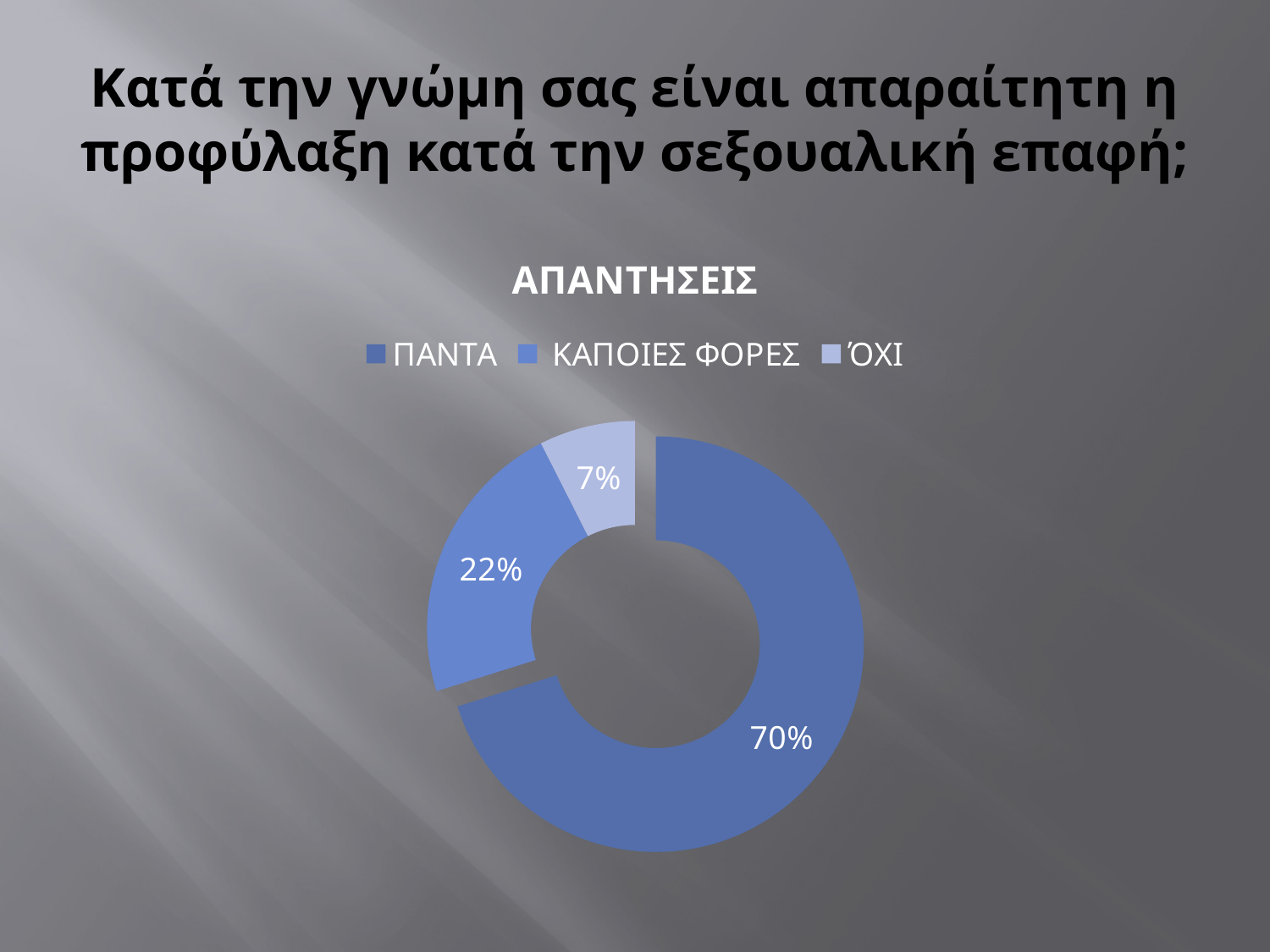
What is the difference in percentage points between ΚΑΠΟΙΕΣ ΦΟΡΕΣ and ΌΧΙ? 15 Which response category has the largest share? ΠΑΝΤΑ How many categories are shown in the chart? 3 Which response category has the smallest share? ΌΧΙ What percentage of responses is ΠΑΝΤΑ? 70% What percentage of responses is ΌΧΙ? 7% What is the title of the chart? ΑΠΑΝΤΗΣΕΙΣ Which category is shown in the lightest colour in the legend? ΌΧΙ What kind of chart is shown on the slide? Doughnut (pie) chart What is the difference in percentage points between ΠΑΝΤΑ and ΚΑΠΟΙΕΣ ΦΟΡΕΣ? 48 What percentage of responses is ΚΑΠΟΙΕΣ ΦΟΡΕΣ? 22% Which is larger, the share for ΚΑΠΟΙΕΣ ΦΟΡΕΣ or the share for ΌΧΙ? ΚΑΠΟΙΕΣ ΦΟΡΕΣ